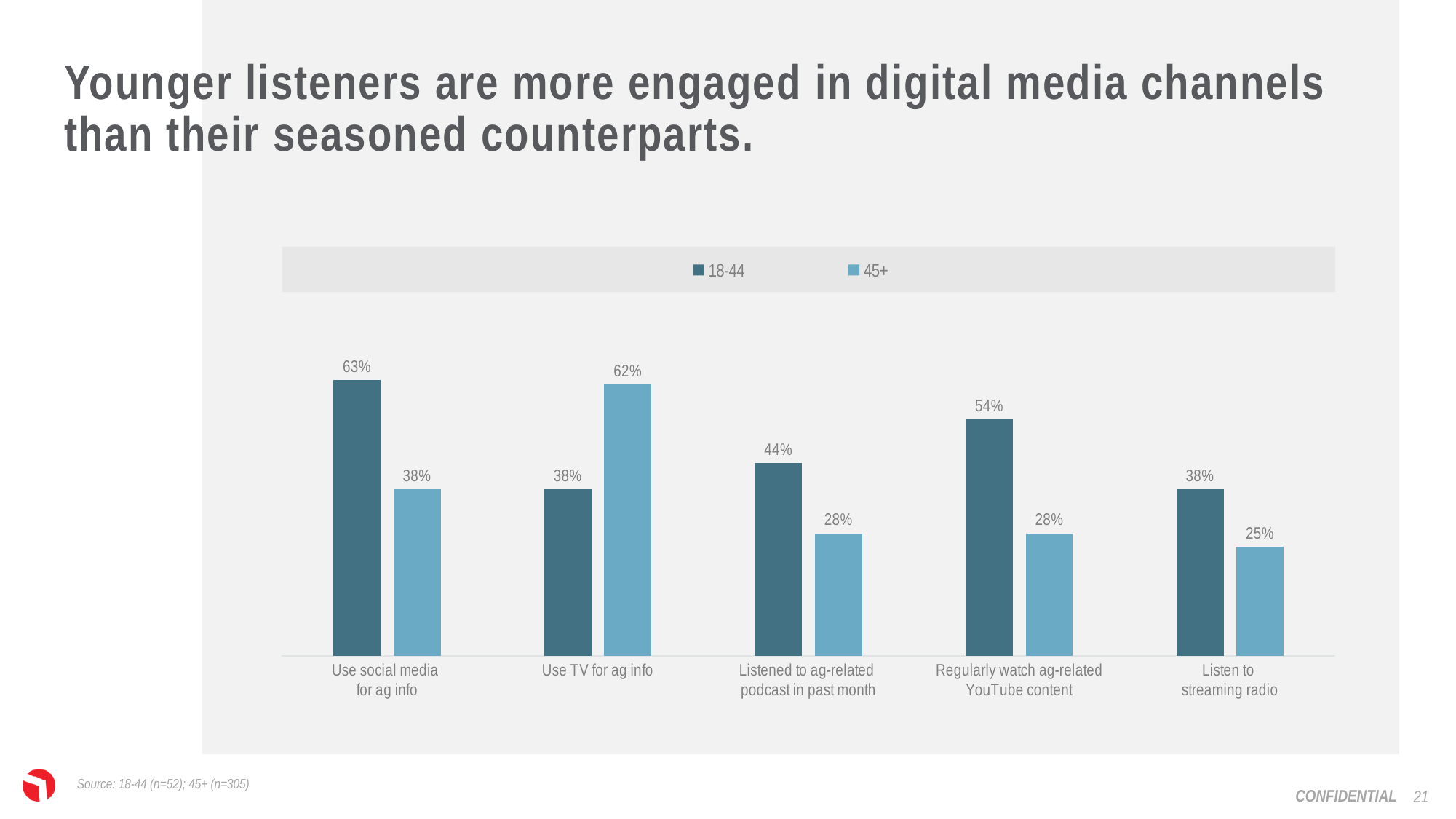
What percentage of the 45+ group use TV for ag info? 62% For 'Use TV for ag info', which group has the larger value, 18-44 or 45+? 45+ What is the value for the 45+ group for 'Listen to streaming radio'? 25% How many series does the legend list? 2 What are the two series named in the legend? 18-44 and 45+ What is the difference between the 18-44 and 45+ values for 'Use social media for ag info'? 25 percentage points Which category has the lowest value for the 45+ series? Listen to streaming radio What percentage of the 18-44 group use social media for ag info? 63% Which category has the highest value for the 18-44 series? Use social media for ag info How many categories are shown on the x axis? 5 What is the value for the 18-44 group for 'Regularly watch ag-related YouTube content'? 54% What kind of chart is shown on the slide? Bar chart